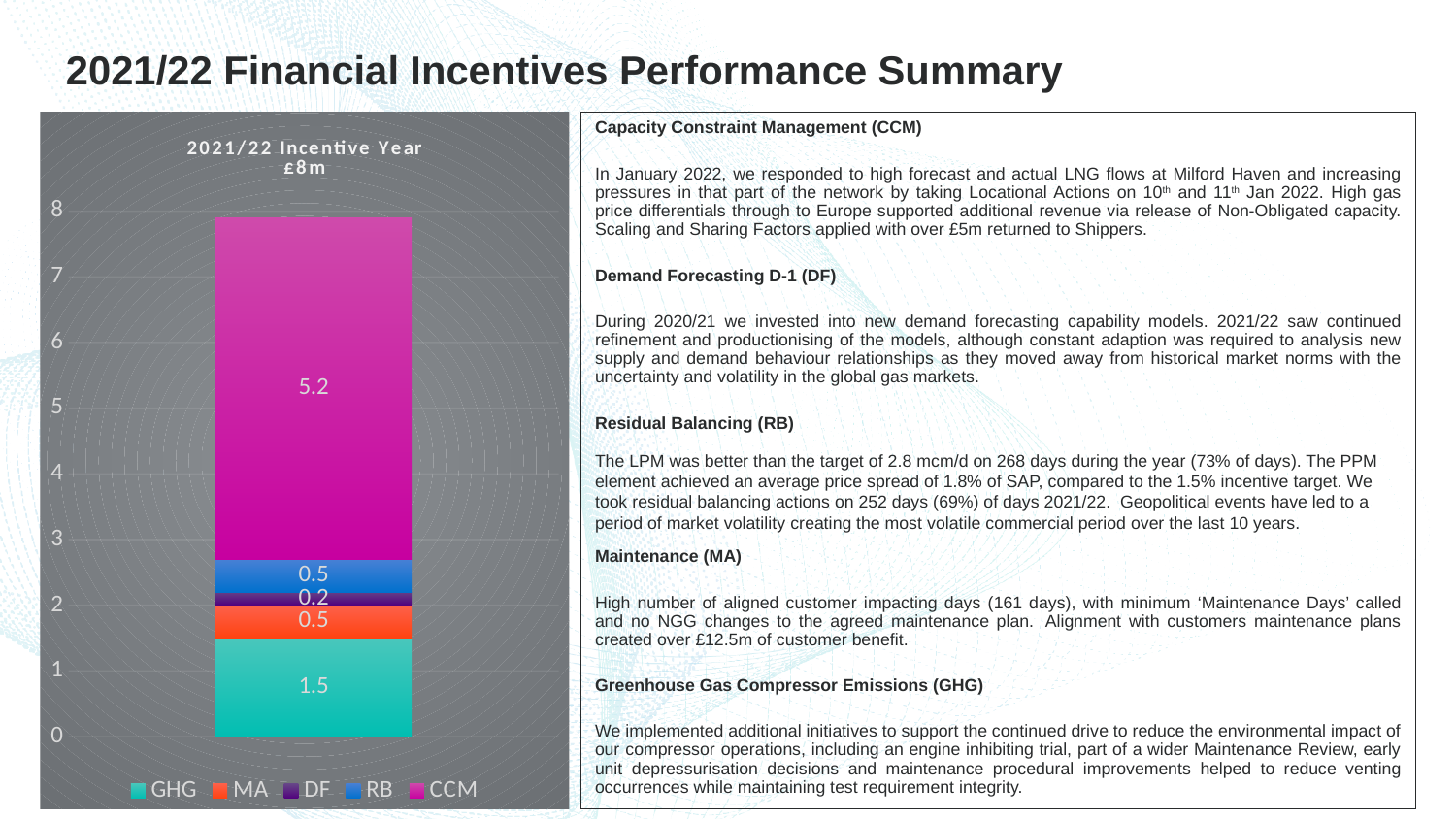
What is the value of the GHG segment in the stacked bar? 1.5 Which series has the smallest segment in the stacked bar? DF What is the value of the CCM segment in the stacked bar? 5.2 How many series does the chart legend list? 5 Which series is shown in magenta in the legend? CCM What type of chart is shown on the slide? stacked bar chart What is the difference between the CCM and GHG segment values? 3.7 What is the total of all segments in the stacked bar? 7.9 Which is larger, the GHG segment or the RB segment? GHG Which series has the largest segment in the stacked bar? CCM What is the title of the chart? 2021/22 Incentive Year £8m What is the value of the DF segment in the stacked bar? 0.2